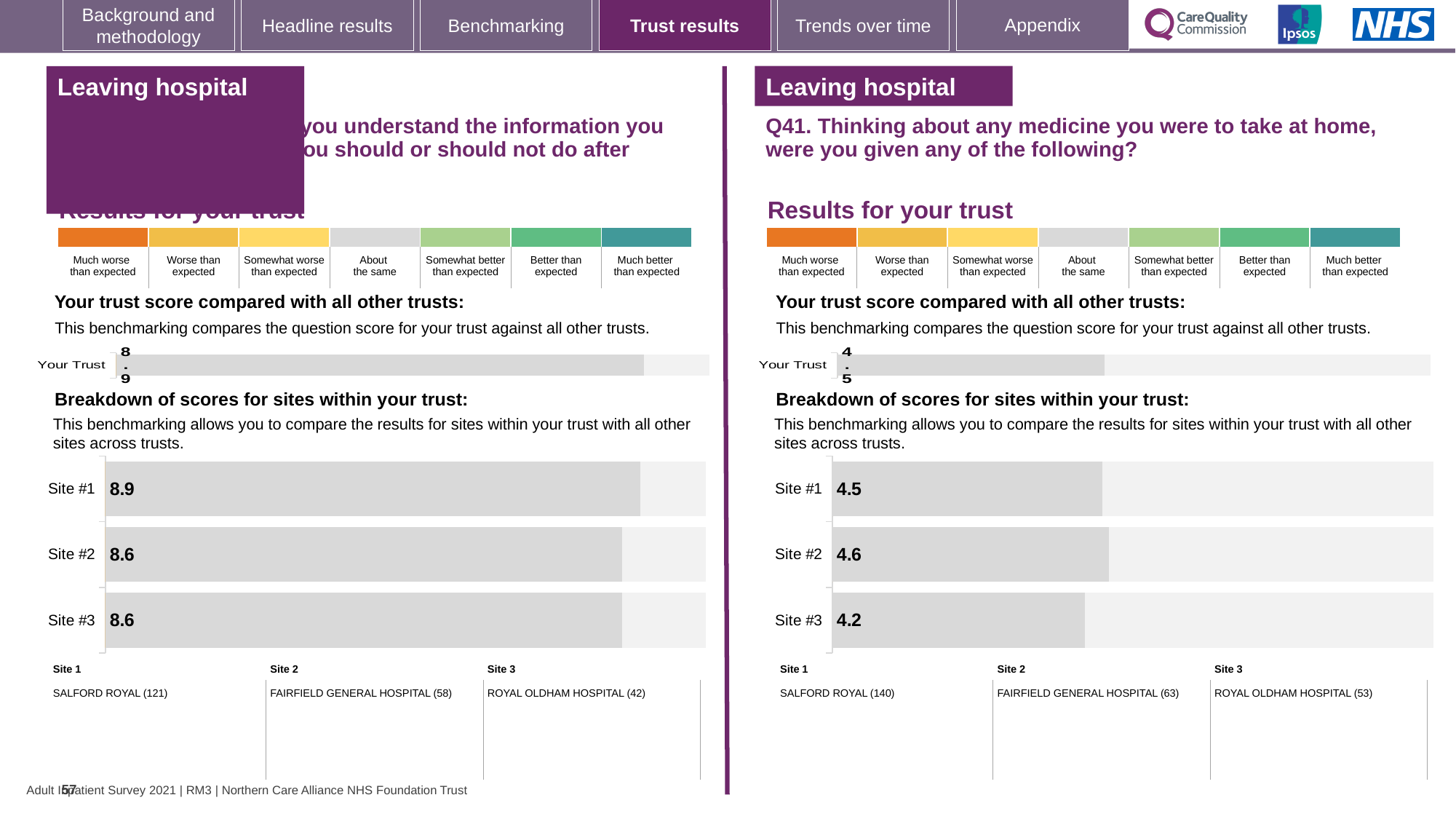
On the right-hand (Q41) site breakdown chart, which site has the lowest score? Site #3 On the right-hand (Q41) site breakdown chart, which site has the highest score? Site #2 What type of chart is used for the site breakdown on the right-hand (Q41) panel? Bar chart On the right-hand (Q41) site breakdown chart, what is the score for Site #3? 4.2 On the left-hand site breakdown chart, how many sites are shown? 3 On the left-hand 'Your Trust' bar chart, what is the trust score shown? 8.9 On the right-hand (Q41) site breakdown chart, what is the difference between the scores for Site #2 and Site #3? 0.4 On the left-hand site breakdown chart, what is the difference between the scores for Site #1 and Site #3? 0.3 On the left-hand site breakdown chart, which site has the highest score? Site #1 On the right-hand (Q41) site breakdown chart, what is the score for Site #1? 4.5 On the left-hand site breakdown chart, what is the score for Site #2? 8.6 On the right-hand (Q41) 'Your Trust' bar chart, what is the trust score shown? 4.5